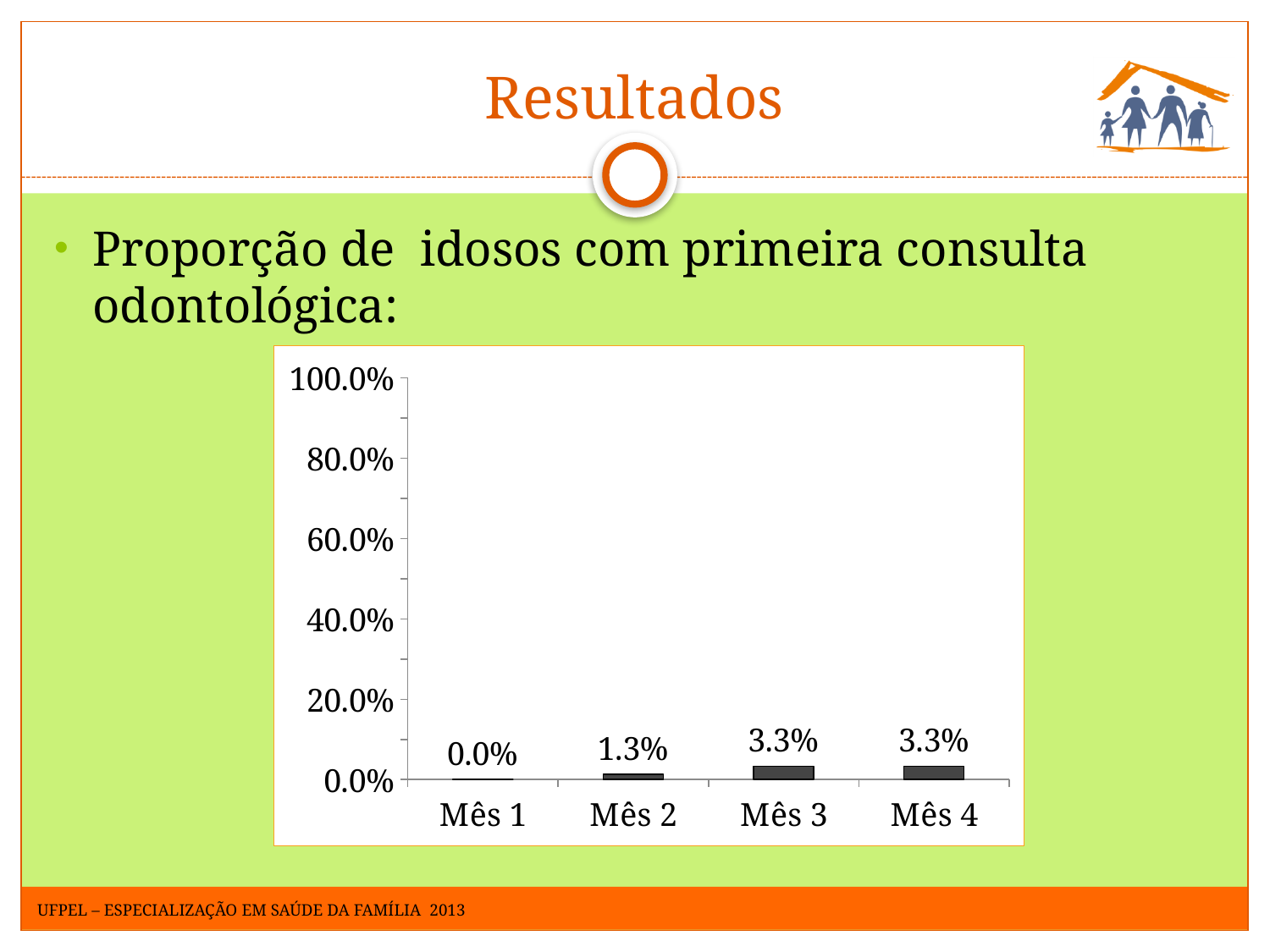
What is the value for Mês 2? 1.3% How many months are shown on the x axis? 4 What is the highest value shown on the y axis? 100.0% What is the value for Mês 4? 3.3% Which month has the lowest value? Mês 1 Do the values rise or fall from Mês 1 to Mês 3? rise Is the value for Mês 4 greater or less than 20.0%? less What is the difference between the values for Mês 4 and Mês 1? 3.3% What is the difference between the values for Mês 3 and Mês 2? 2.0% What is the value for Mês 1? 0.0% What kind of chart is shown on the slide? bar chart Which is larger, the value for Mês 2 or the value for Mês 3? Mês 3